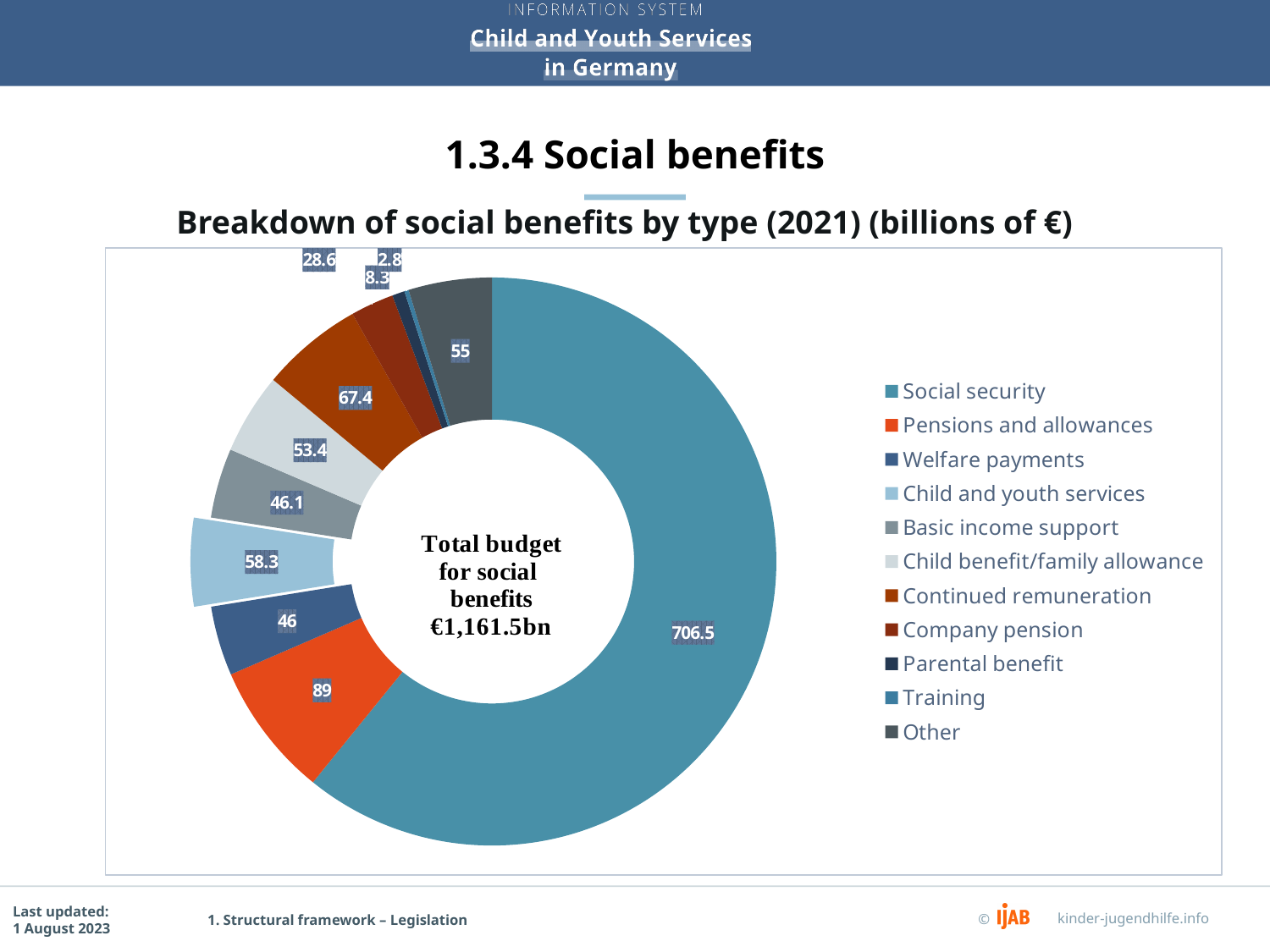
What is the difference between Social security and Pensions and allowances? 617.5 What is the value for Social security? 706.5 What is the difference between Continued remuneration and Child benefit/family allowance? 14 Which is larger, Pensions and allowances or Other? Pensions and allowances Which category has the largest slice? Social security What is the value for Training? 2.8 Which category has the smallest slice? Training What total budget is shown in the centre of the chart? €1,161.5bn What is the value for Continued remuneration? 67.4 What is the value for Child and youth services? 58.3 What type of chart is shown on the slide? Pie (doughnut) chart How many categories does the legend list? 11